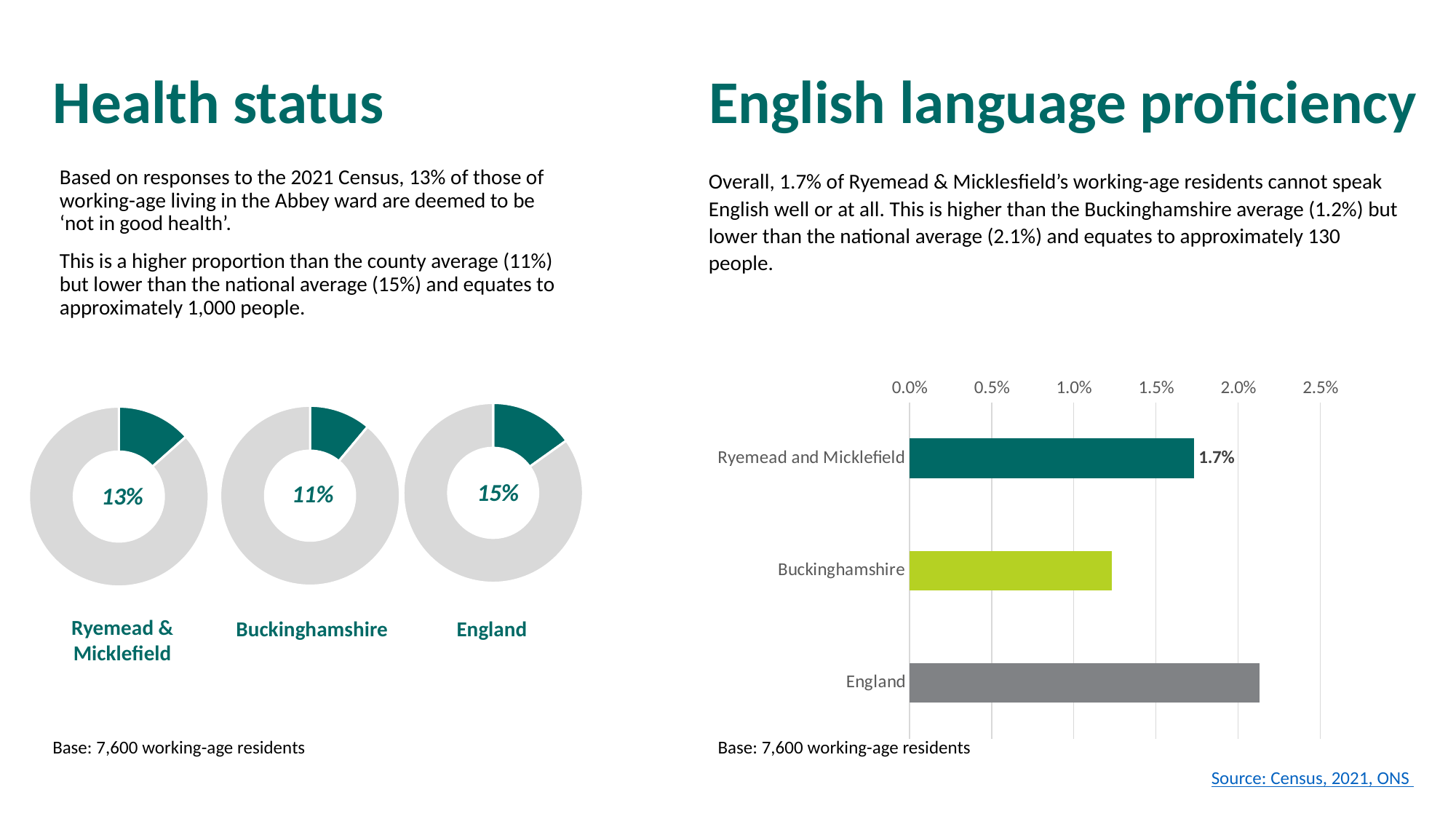
In the English language proficiency chart, is the value for England greater or less than 2.0%? greater What kind of chart is used for English language proficiency? Bar chart In the English language proficiency chart, is the value for Buckinghamshire greater or less than 1.5%? less In the Health status donut charts, what percentage is shown for England? 15% In the Health status donut charts, what percentage is shown for Buckinghamshire? 11% How many donut charts are shown under Health status? 3 In the Health status donut charts, what percentage is shown for Ryemead & Micklefield? 13% In the Health status donut charts, which area has the highest percentage? England In the Health status donut charts, what is the difference between the England value and the Buckinghamshire value? 4% In the English language proficiency chart, which area has the longest bar? England In the English language proficiency chart, what is the value for Ryemead and Micklefield? 1.7% In the Health status donut charts, which area has the lowest percentage? Buckinghamshire